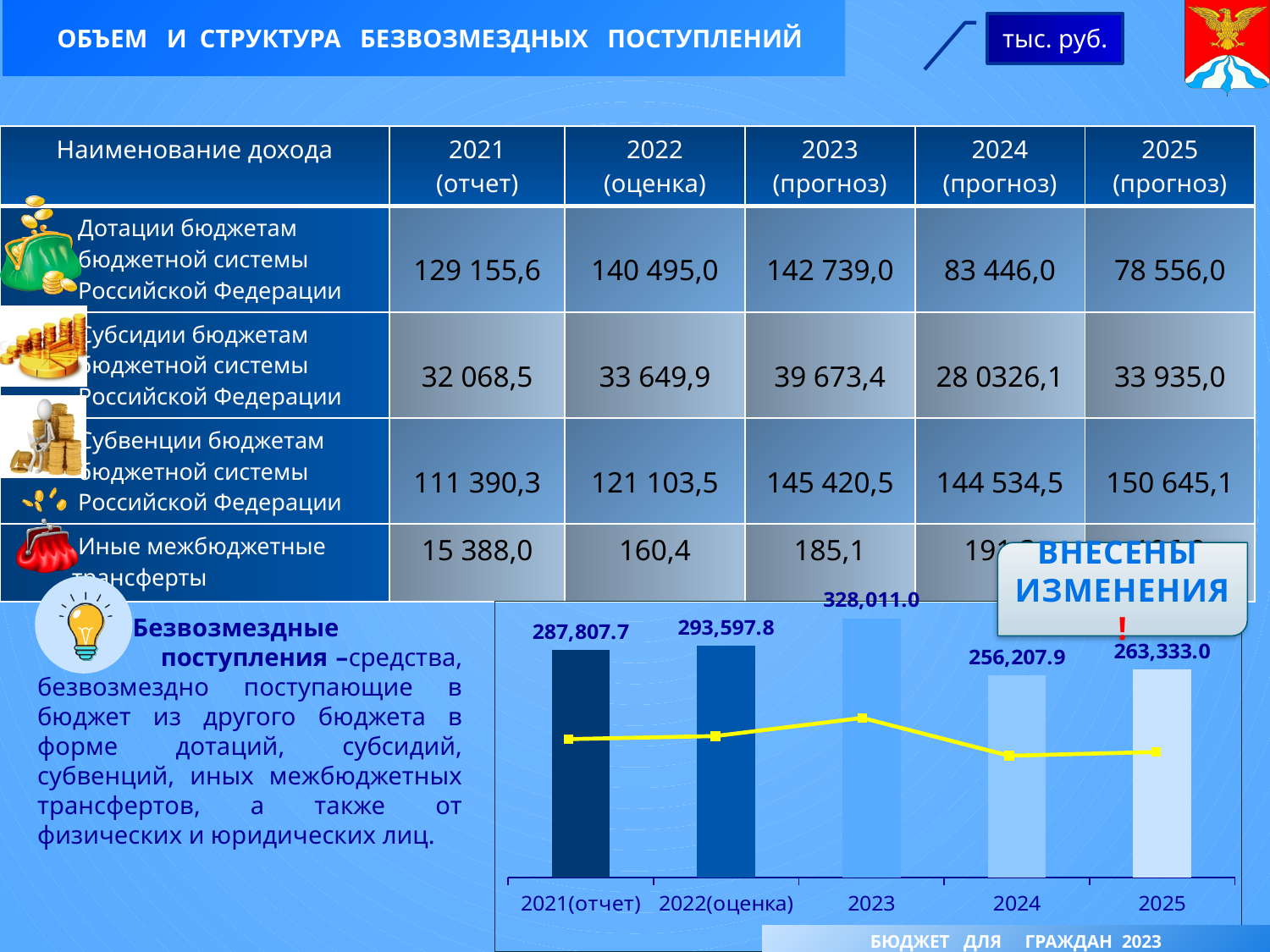
Which year has the highest bar in the chart? 2023 What is the value of the bar for 2023 in the chart? 328,011.0 What is the value of the bar for 2024 in the chart? 256,207.9 What is the difference between the bar values for 2023 and 2024? 71,803.1 How many categories are shown on the x axis of the chart? 5 What is the value of the bar for 2025 in the chart? 263,333.0 What is the value of the bar for 2021(отчет) in the chart? 287,807.7 What kind of chart is shown at the bottom of the slide? bar chart with a line What is the difference between the bar values for 2022(оценка) and 2021(отчет)? 5,790.1 Which year has the lowest bar in the chart? 2024 Which bar is larger, 2025 or 2024? 2025 Do the bar values rise or fall from 2021(отчет) to 2023? rise